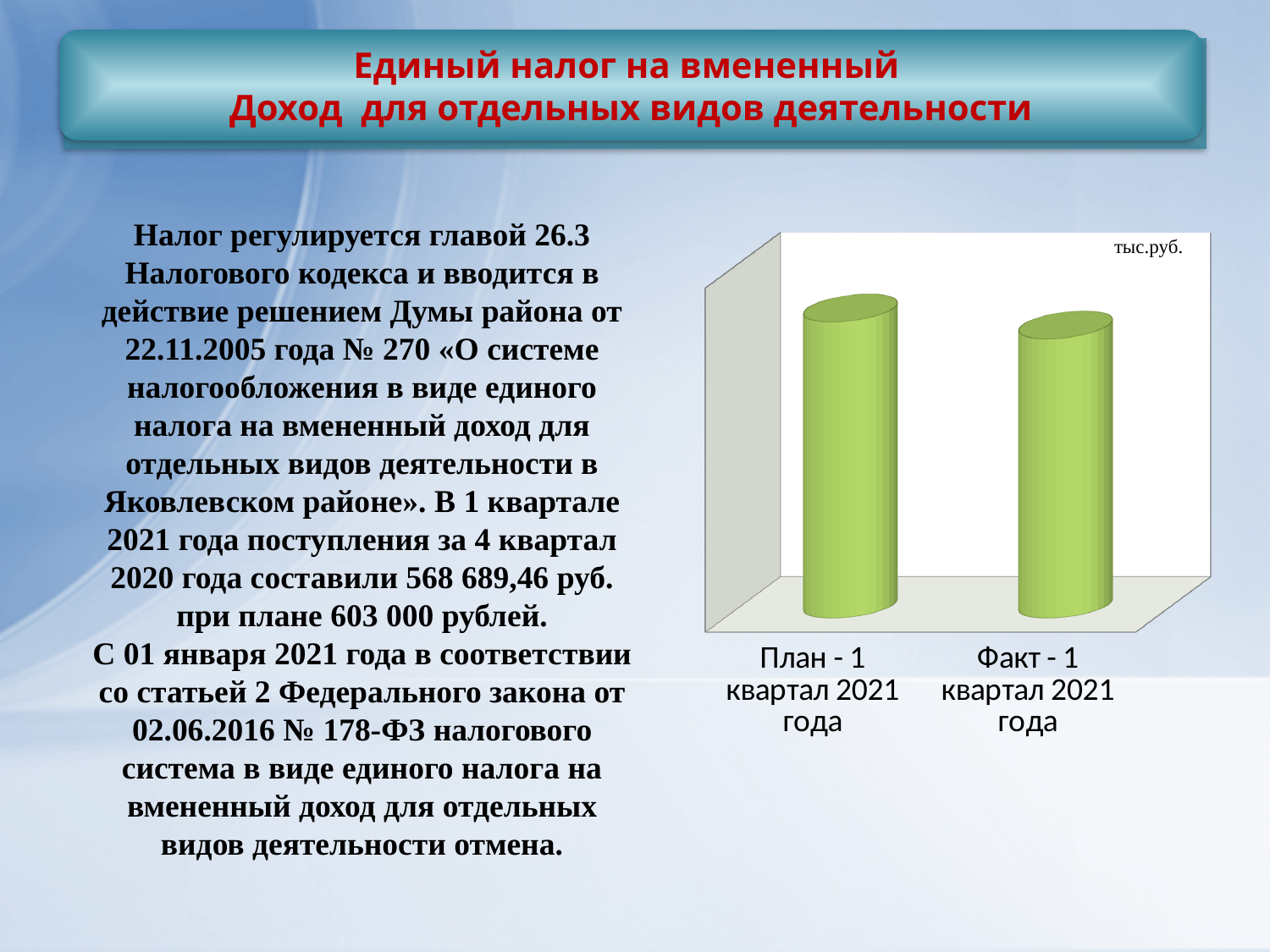
Do the bar values rise or fall from План - 1 квартал 2021 года to Факт - 1 квартал 2021 года? fall What unit label is printed in the top right corner of the chart? тыс.руб. Which category has the lower bar in the chart? Факт - 1 квартал 2021 года Which category has the higher bar in the chart? План - 1 квартал 2021 года What colour are the bars in the chart? green How many bars does the chart show? 2 What kind of chart is shown on the slide? bar chart Is the bar for План - 1 квартал 2021 года taller or shorter than the bar for Факт - 1 квартал 2021 года? taller